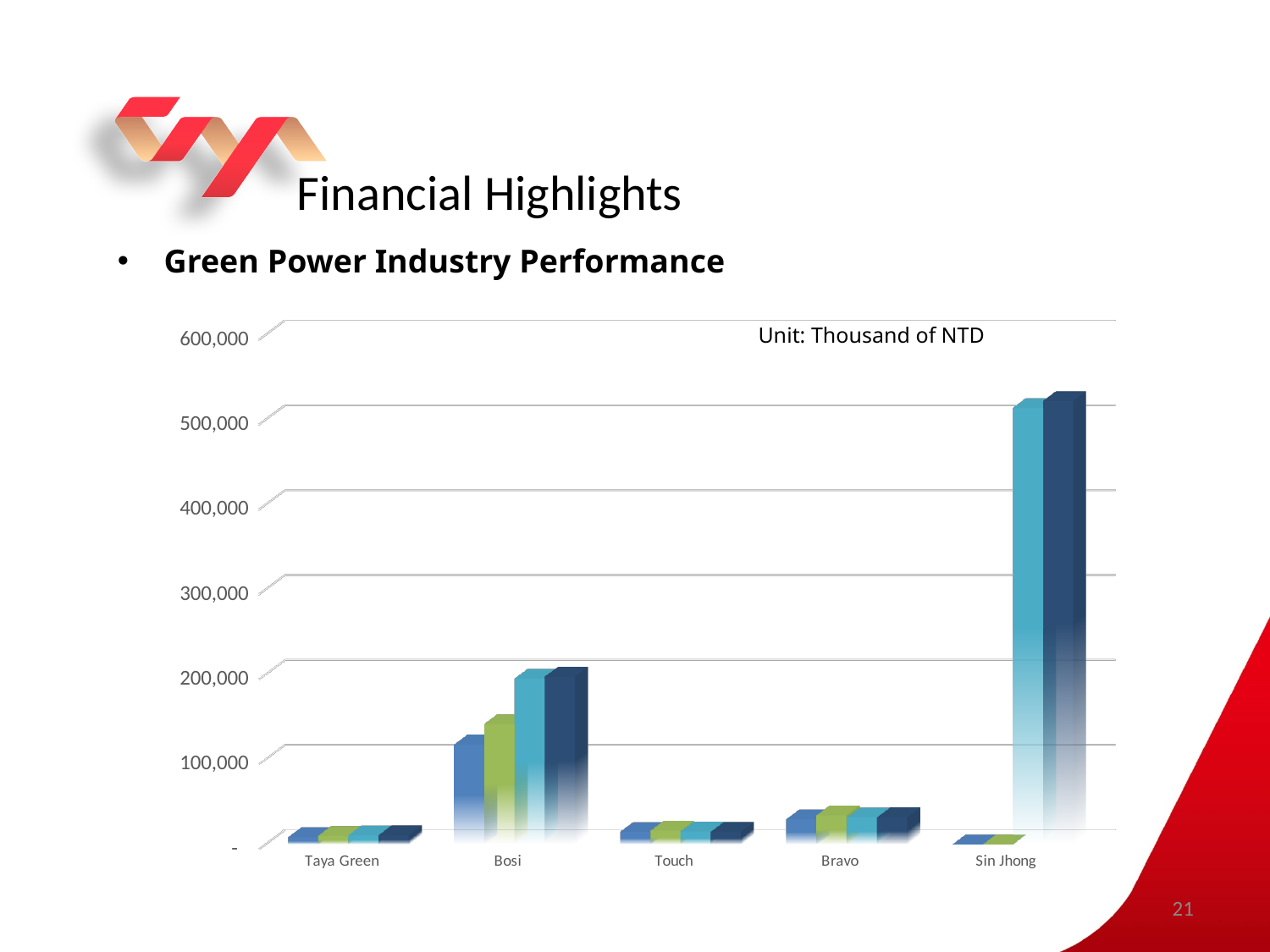
Which category has taller bars, Bosi or Bravo? Bosi Is the tallest bar for Taya Green greater or less than 100,000? less Which category has the tallest bars in the chart? Sin Jhong How many categories are shown on the x axis of the chart? 5 Is the tallest bar for Bosi greater or less than 100,000? greater Is the tallest bar for Bravo greater or less than 100,000? less What kind of chart is shown on the slide? bar chart Which category has taller bars, Sin Jhong or Bosi? Sin Jhong What unit is stated for the values in the chart? Thousand of NTD What is the highest value labelled on the vertical axis of the chart? 600,000